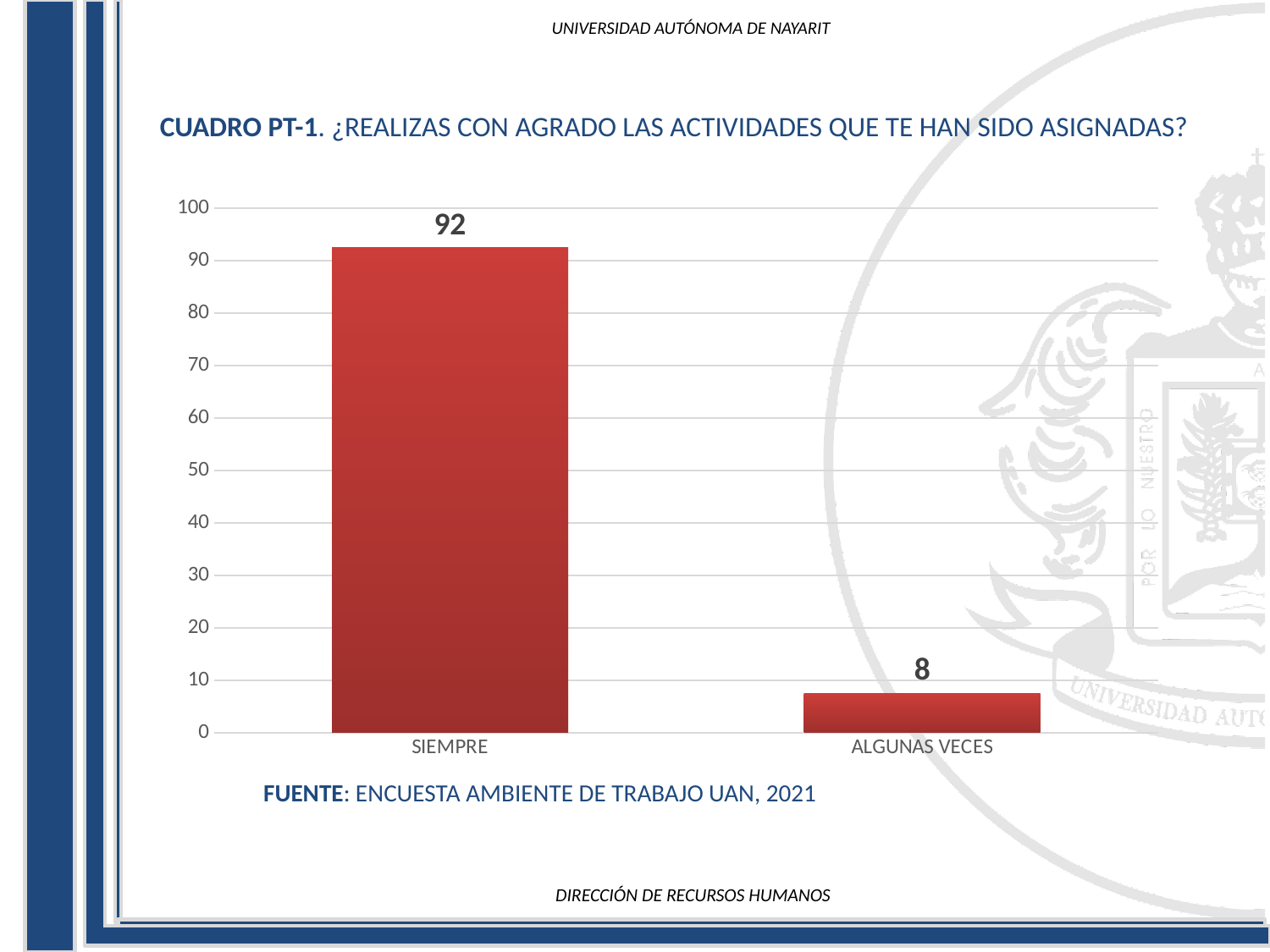
What is the value for ALGUNAS VECES? 8 Is the value for SIEMPRE greater or less than 90? greater Which category has the lowest value? ALGUNAS VECES What kind of chart is shown on the slide? bar chart How many categories are shown on the chart? 2 Is the value for ALGUNAS VECES greater or less than 10? less Which is larger, the value for SIEMPRE or the value for ALGUNAS VECES? SIEMPRE What is the difference between the values for SIEMPRE and ALGUNAS VECES? 84 Which category has the highest value? SIEMPRE What is the value for SIEMPRE? 92 What source is cited below the chart? ENCUESTA AMBIENTE DE TRABAJO UAN, 2021 What is the total of the two values shown on the chart? 100